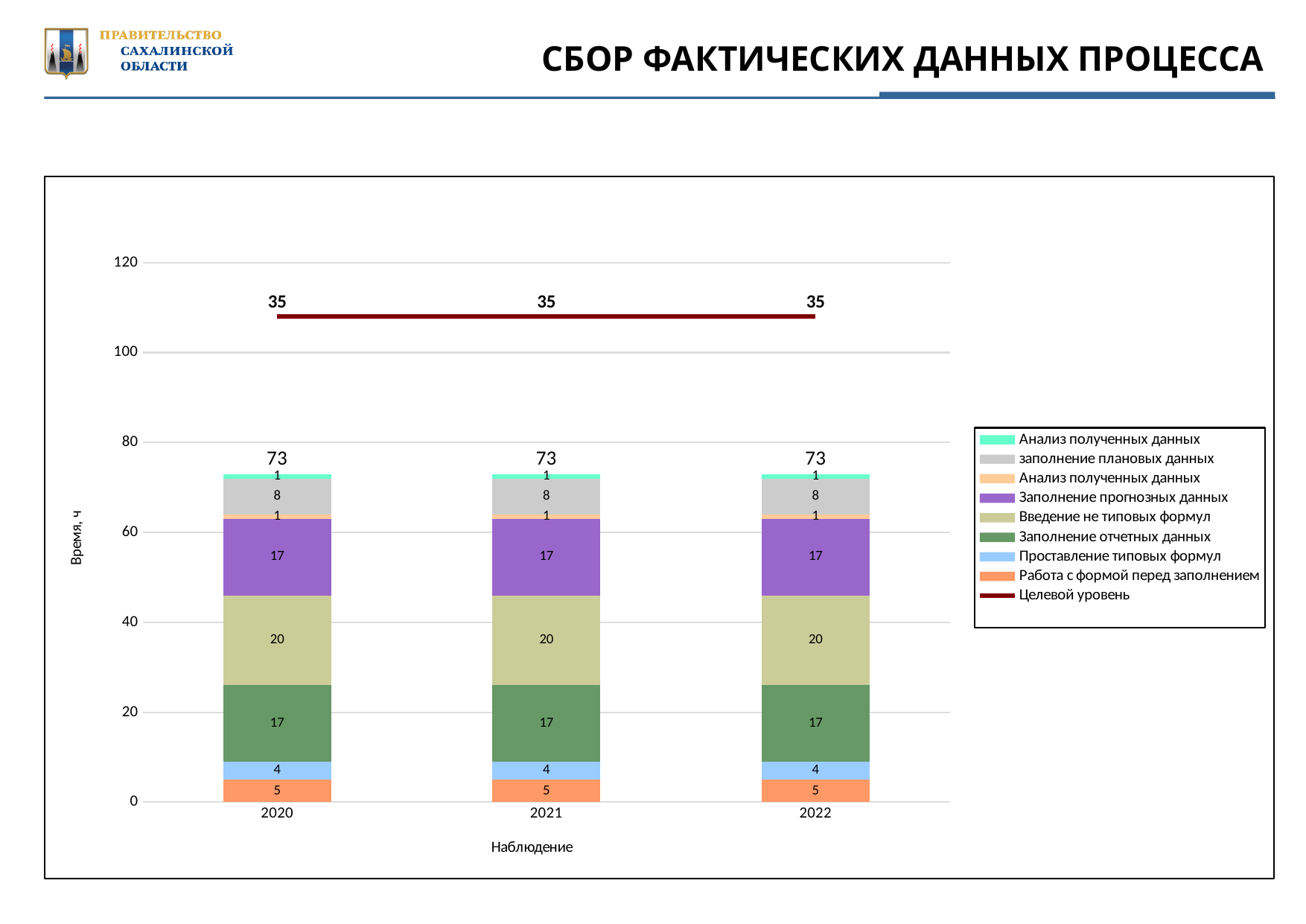
What is the value of "Заполнение отчетных данных" for 2022? 17 Do the bar totals rise, fall or stay the same from 2020 to 2022? Stay the same What is the value of "заполнение плановых данных" for 2022? 8 What is the total of the stacked bar for 2020? 73 How many entries does the legend list? 9 What is the value of "Введение не типовых формул" for 2021? 20 What kind of chart is shown on the slide? Stacked bar chart with a target line What value is labelled on the "Целевой уровень" line for 2021? 35 Which segment is the largest in the 2021 stacked bar? Введение не типовых формул What is the value of "Проставление типовых формул" for 2021? 4 How many categories (years) are shown on the x axis? 3 What is the value of "Работа с формой перед заполнением" for 2020? 5